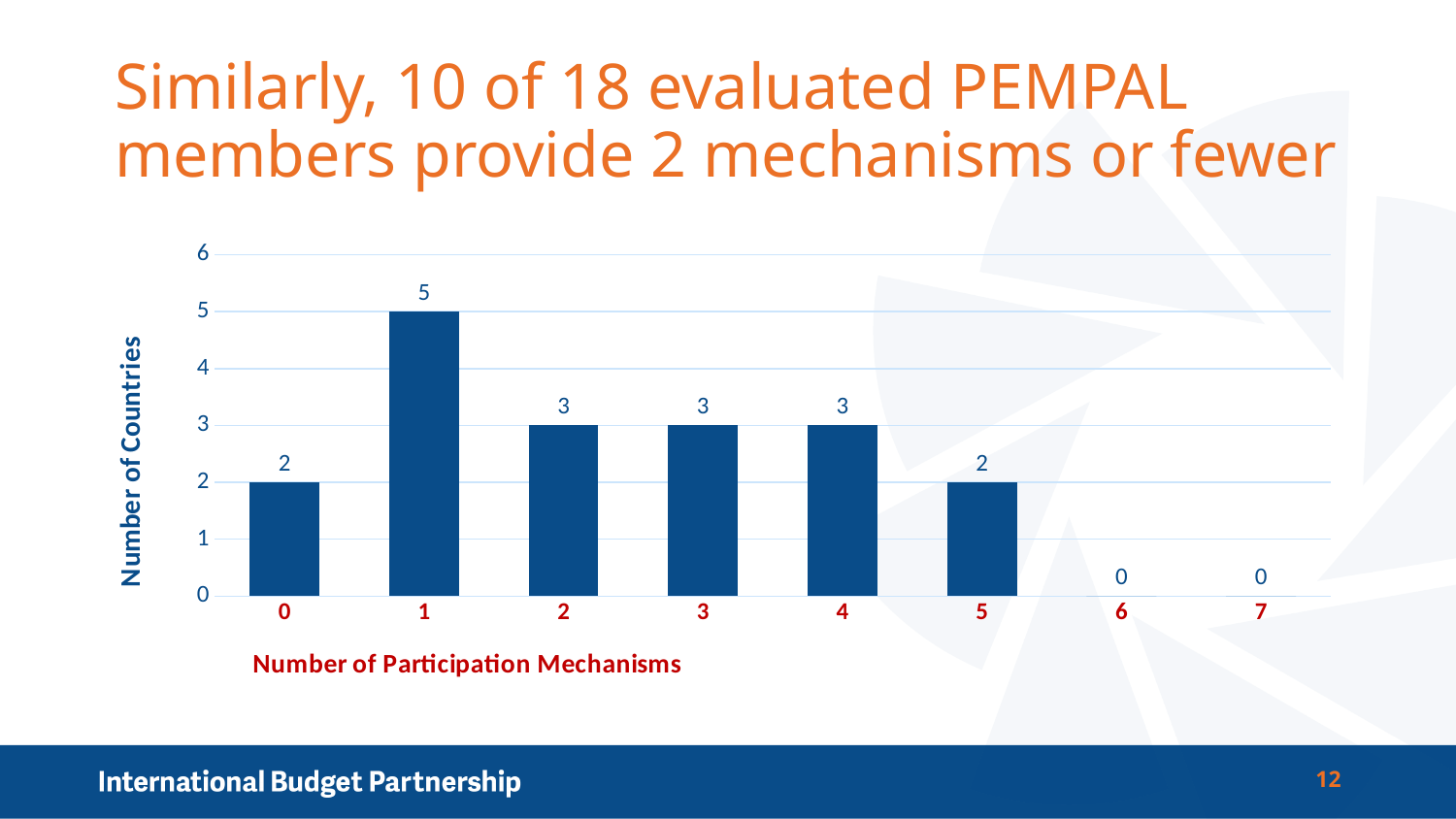
How many categories are shown on the x axis? 8 How many countries provide 5 participation mechanisms? 2 What is the difference between the number of countries with 1 mechanism and the number with 2 mechanisms? 2 What is the label of the y axis? Number of Countries Which has more countries: 4 participation mechanisms or 5 participation mechanisms? 4 How many countries provide 0 participation mechanisms? 2 What is the label of the x axis? Number of Participation Mechanisms What kind of chart is shown on the slide? bar chart Which number of participation mechanisms has the highest number of countries? 1 How many countries provide 7 participation mechanisms? 0 What is the total number of countries with 3 or 4 participation mechanisms combined? 6 How many countries provide 1 participation mechanism? 5